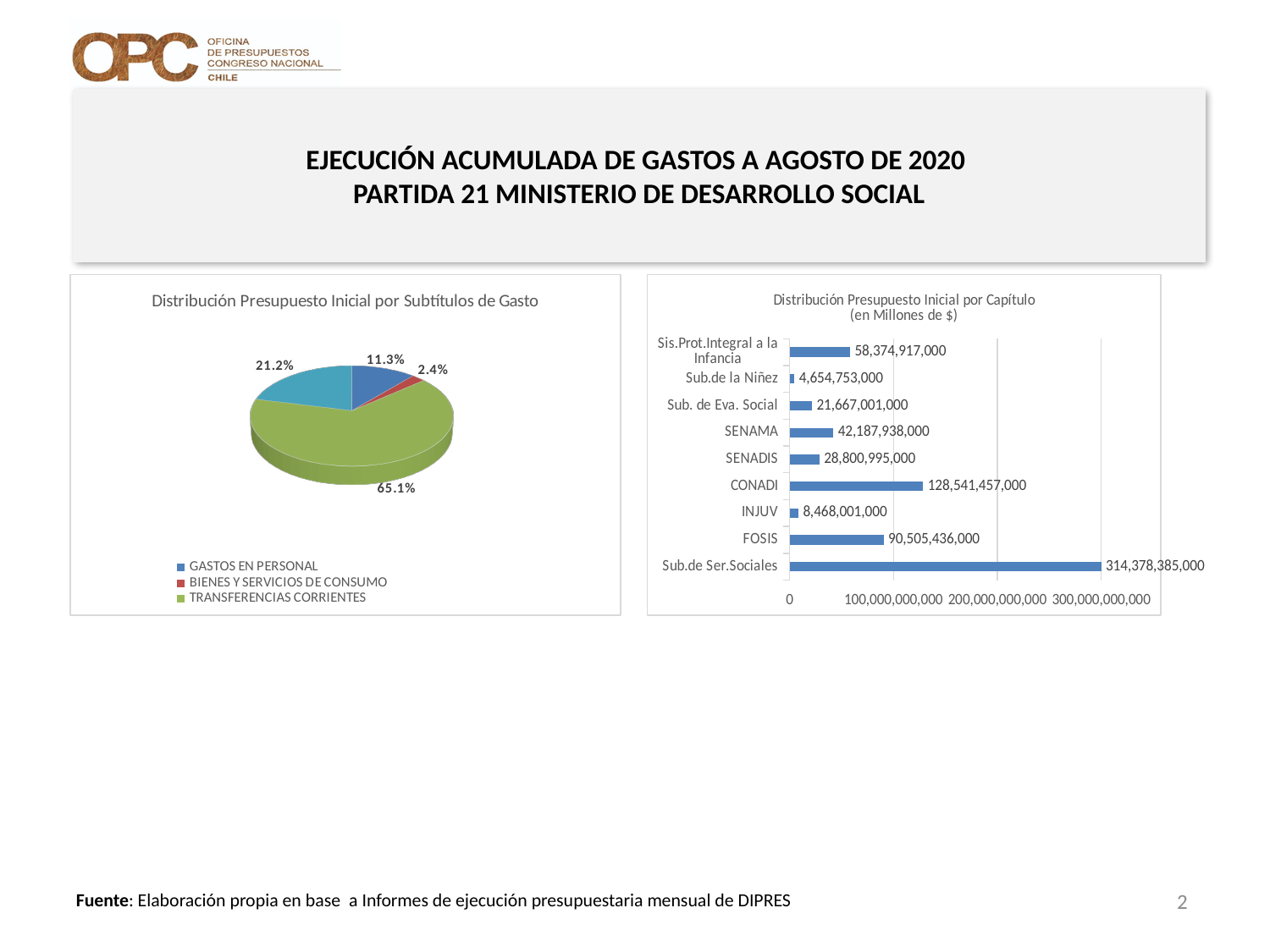
In the pie chart titled 'Distribución Presupuesto Inicial por Subtítulos de Gasto', what share does TRANSFERENCIAS CORRIENTES have? 65.1% In the chart titled 'Distribución Presupuesto Inicial por Capítulo', how many capítulos are shown? 9 In the chart titled 'Distribución Presupuesto Inicial por Capítulo', what is the value for FOSIS? 90,505,436,000 In the chart titled 'Distribución Presupuesto Inicial por Capítulo', what is the value for CONADI? 128,541,457,000 In the chart titled 'Distribución Presupuesto Inicial por Capítulo', what is the difference between the values for SENAMA and SENADIS? 13,386,943,000 In the pie chart titled 'Distribución Presupuesto Inicial por Subtítulos de Gasto', what is the smallest percentage shown? 2.4% In the chart titled 'Distribución Presupuesto Inicial por Capítulo', which is larger, the value for INJUV or the value for Sub. de Eva. Social? Sub. de Eva. Social In the pie chart titled 'Distribución Presupuesto Inicial por Subtítulos de Gasto', what share does GASTOS EN PERSONAL have? 11.3% In the chart titled 'Distribución Presupuesto Inicial por Capítulo', which capítulo has the highest value? Sub.de Ser.Sociales How many entries does the legend of the pie chart titled 'Distribución Presupuesto Inicial por Subtítulos de Gasto' list? 3 In the chart titled 'Distribución Presupuesto Inicial por Capítulo', which capítulo has the lowest value? Sub.de la Niñez What kind of chart is the chart titled 'Distribución Presupuesto Inicial por Capítulo'? Bar chart